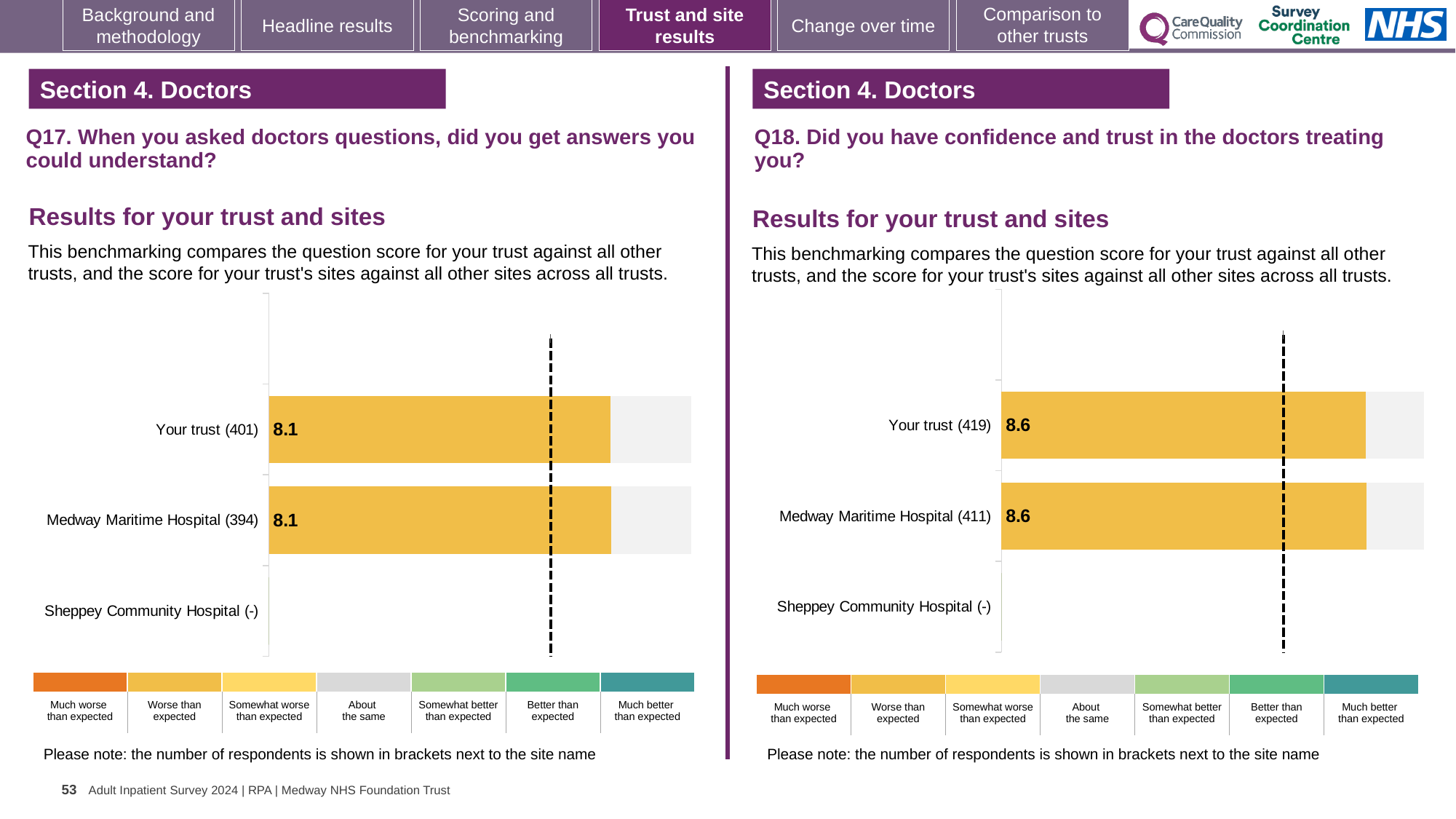
On the Q18 chart (right), what is the score for Your trust? 8.6 On the Q17 chart (left), what is the score for Medway Maritime Hospital? 8.1 On the Q18 chart (right), how many site/trust categories are listed on the axis? 3 On the Q18 chart (right), how many respondents are shown in brackets for Your trust? 419 What is the difference between the Your trust score on the Q18 chart (right) and the Your trust score on the Q17 chart (left)? 0.5 On the Q18 chart (right), what is the score for Medway Maritime Hospital? 8.6 On the Q17 chart (left), how many site/trust categories are listed on the axis? 3 On the Q17 chart (left), is the score for Your trust the same as the score for Medway Maritime Hospital? Yes, both 8.1 What kind of chart is used on the Q17 chart (left)? Bar chart Which is larger: the Your trust score on the Q17 chart (left) or the Your trust score on the Q18 chart (right)? Q18 (8.6) On the Q17 chart (left), what is the score for Your trust? 8.1 On the Q17 chart (left), which category has no score shown? Sheppey Community Hospital (-)